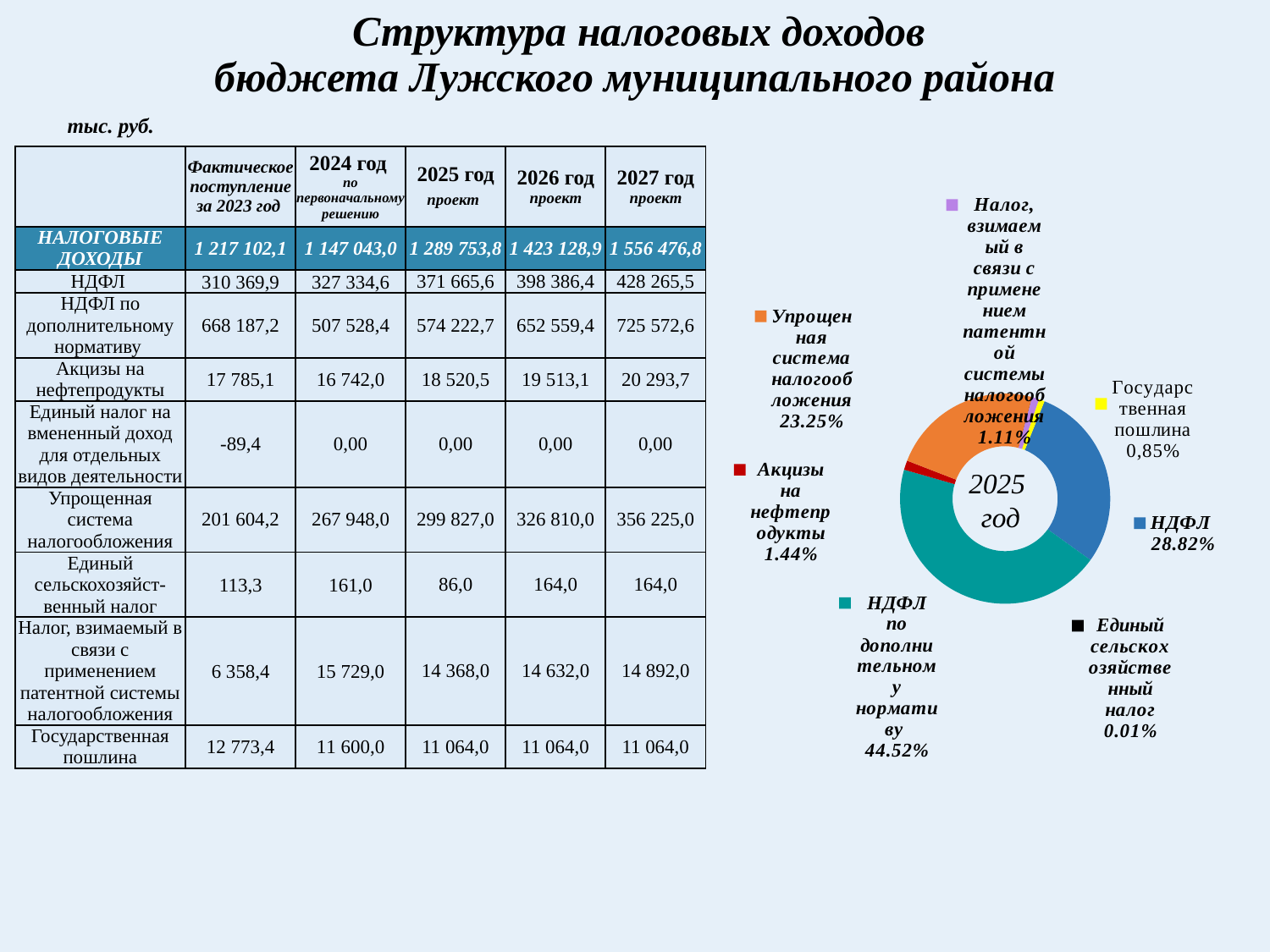
In the doughnut chart, what share does Акцизы на нефтепродукты have? 1.44% In the doughnut chart, what share does Единый сельскохозяйственный налог have? 0.01% What kind of chart is shown on the right of the slide? Doughnut (pie) chart In the doughnut chart, what share does НДФЛ по дополнительному нормативу have? 44.52% In the doughnut chart, which is larger: the share of НДФЛ or the share of Упрощенная система налогообложения? НДФЛ Which category has the largest share in the doughnut chart? НДФЛ по дополнительному нормативу Which category has the smallest share in the doughnut chart? Единый сельскохозяйственный налог How many categories are shown in the doughnut chart? 7